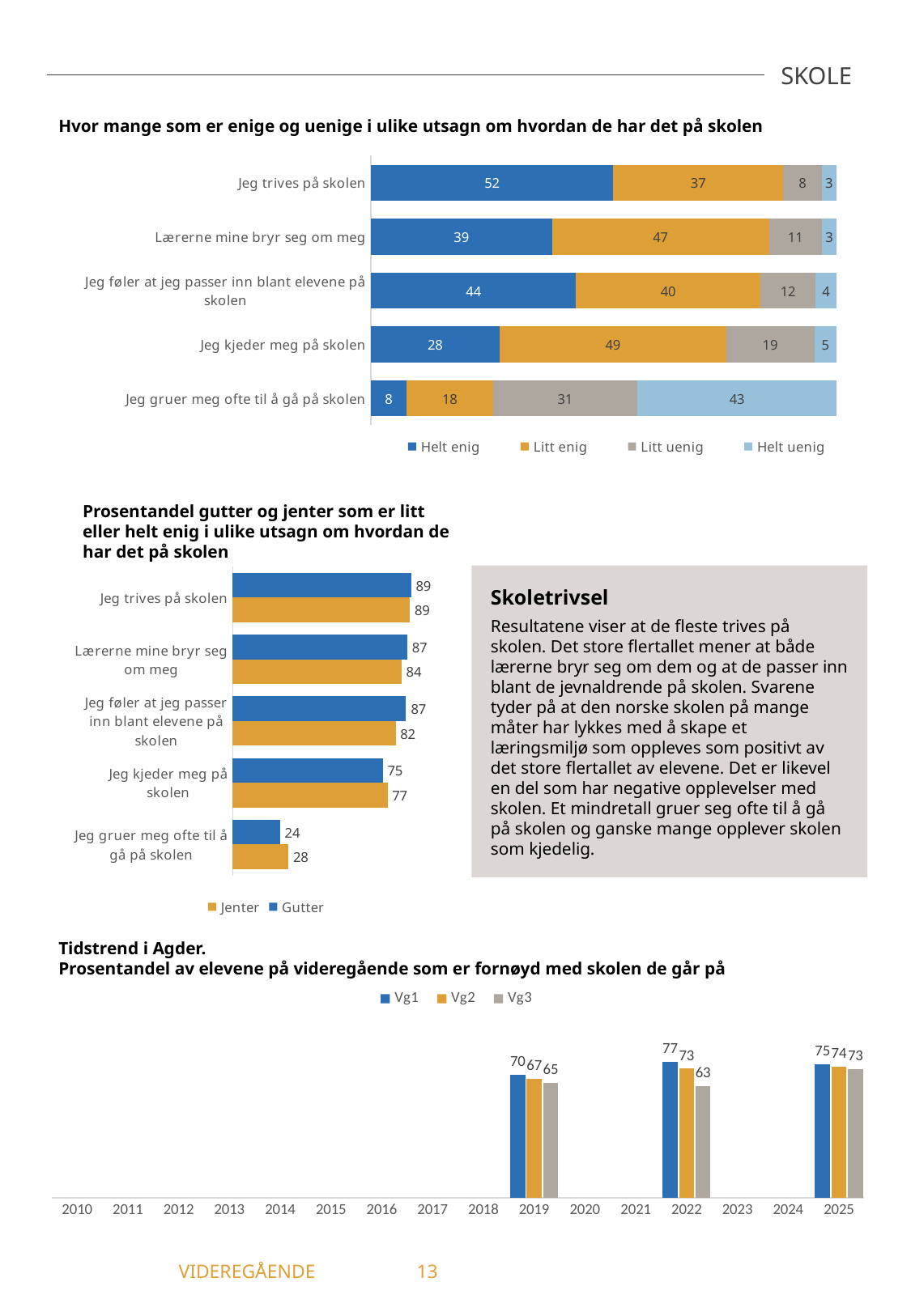
In the bottom chart 'Tidstrend i Agder', which year has the lowest Vg3 value? 2022 What kind of chart is the bottom chart 'Tidstrend i Agder'? Bar chart In the top chart 'Hvor mange som er enige og uenige i ulike utsagn om hvordan de har det på skolen', what is the difference between the 'Litt enig' values for 'Jeg kjeder meg på skolen' and 'Jeg trives på skolen'? 12 In the middle chart 'Prosentandel gutter og jenter som er litt eller helt enig i ulike utsagn om hvordan de har det på skolen', what is the value for Jenter for 'Jeg gruer meg ofte til å gå på skolen'? 28 In the top chart 'Hvor mange som er enige og uenige i ulike utsagn om hvordan de har det på skolen', which statement has the lowest 'Helt enig' value? Jeg gruer meg ofte til å gå på skolen In the middle chart 'Prosentandel gutter og jenter som er litt eller helt enig i ulike utsagn om hvordan de har det på skolen', how many statements are shown? 5 In the top chart 'Hvor mange som er enige og uenige i ulike utsagn om hvordan de har det på skolen', how many series does the legend list? 4 In the middle chart 'Prosentandel gutter og jenter som er litt eller helt enig i ulike utsagn om hvordan de har det på skolen', what is the difference between Gutter and Jenter for 'Jeg føler at jeg passer inn blant elevene på skolen'? 5 In the bottom chart 'Tidstrend i Agder', what is the Vg1 value for 2022? 77 In the top chart 'Hvor mange som er enige og uenige i ulike utsagn om hvordan de har det på skolen', what is the 'Helt enig' value for 'Jeg trives på skolen'? 52 In the top chart 'Hvor mange som er enige og uenige i ulike utsagn om hvordan de har det på skolen', what is the 'Helt uenig' value for 'Jeg gruer meg ofte til å gå på skolen'? 43 In the middle chart 'Prosentandel gutter og jenter som er litt eller helt enig i ulike utsagn om hvordan de har det på skolen', which is larger for 'Jeg kjeder meg på skolen': Jenter or Gutter? Jenter